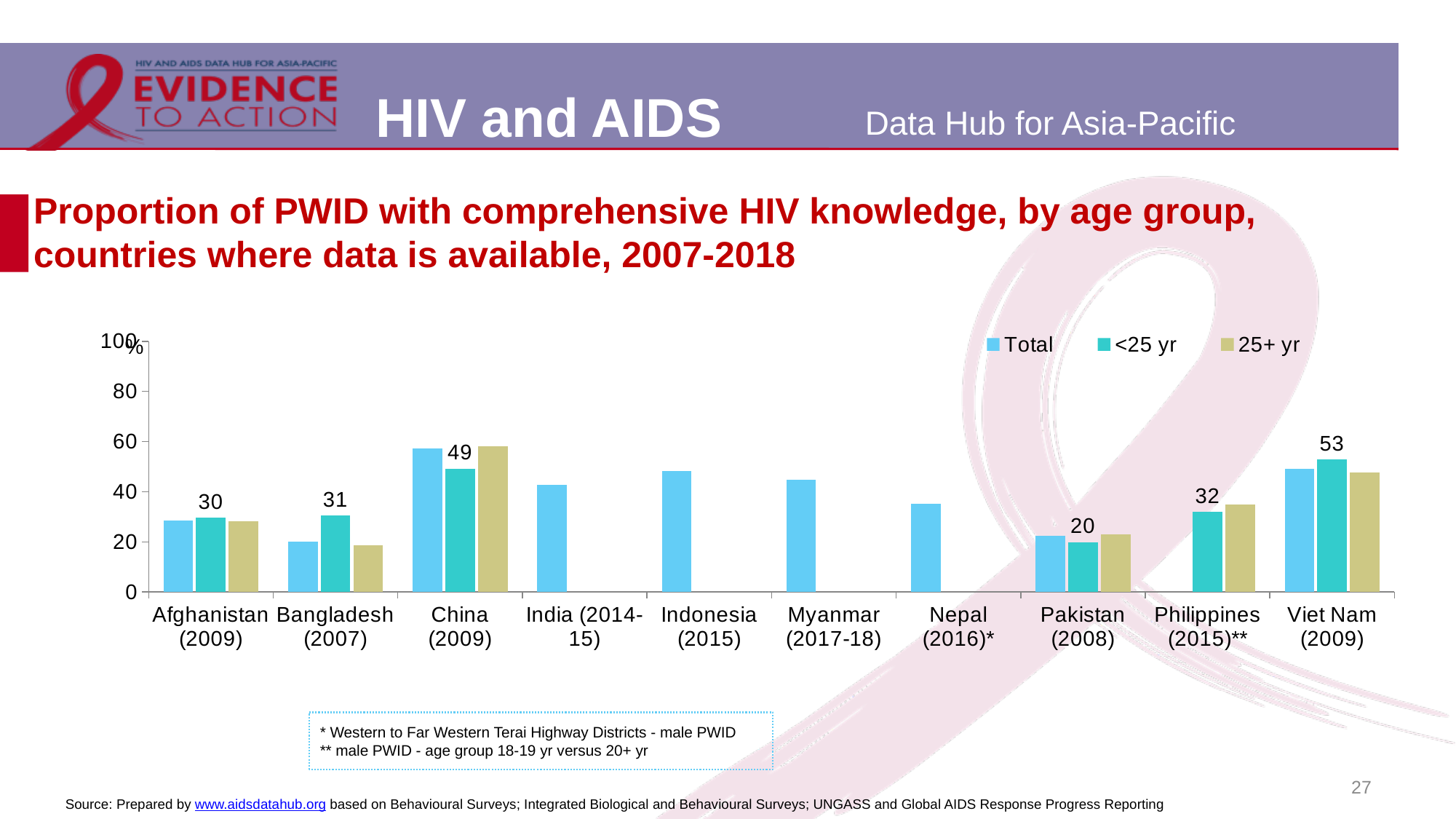
What is the value for the <25 yr series for Pakistan (2008)? 20 What is the difference between the <25 yr values for Viet Nam (2009) and Pakistan (2008)? 33 How many countries are shown on the x axis of the chart? 10 How many series does the legend list? 3 Is the Total value for Indonesia (2015) greater or less than 40? greater Which has the larger <25 yr value, China (2009) or Philippines (2015)**? China (2009) Is the Total value for Nepal (2016)* greater or less than 40? less Among the countries with a labelled <25 yr value, which has the lowest <25 yr value? Pakistan (2008) Among the countries with a labelled <25 yr value, which has the highest <25 yr value? Viet Nam (2009) What is the value for the <25 yr series for China (2009)? 49 What kind of chart is shown on the slide? Bar chart What is the value for the <25 yr series for Viet Nam (2009)? 53